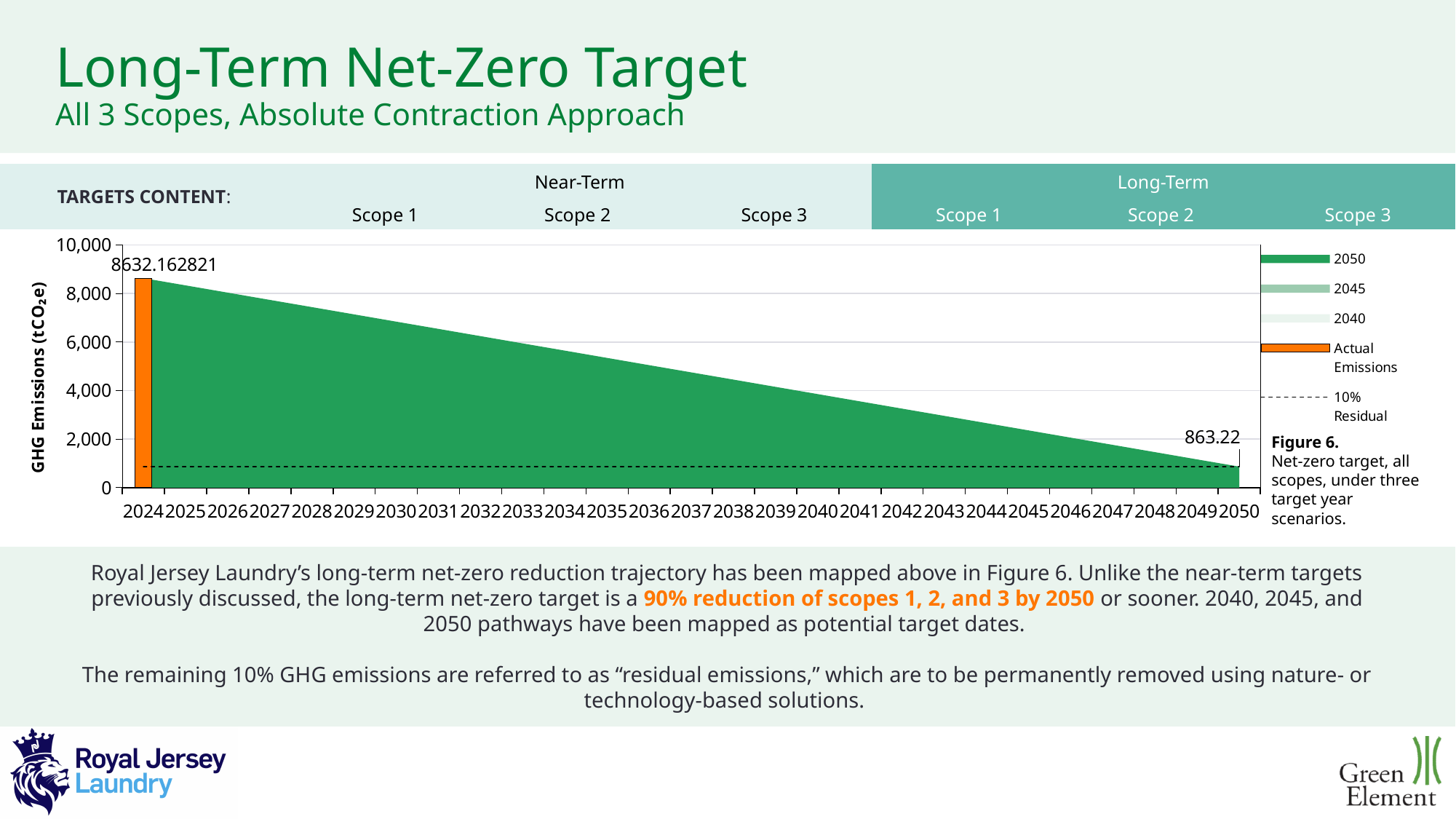
Is the value of the green trajectory in 2045 greater or less than 4,000? less What colour is the Actual Emissions bar in the chart? orange What value is labelled at the end of the trajectory in 2050? 863.22 Is the value of the green trajectory in 2030 greater or less than 6,000? greater What is the highest tick value shown on the y axis? 10,000 What is the label of the y axis? GHG Emissions (tCO₂e) Do the emissions values rise or fall along the x axis from 2024 to 2050? fall What is the difference between the 2024 actual emissions value and the 2050 value? 7768.942821 How many entries does the chart legend list? 5 What is the value of the actual emissions bar for 2024? 8632.162821 How many years are shown on the x axis? 27 Which is larger, the 2024 actual emissions value or the 2050 value? 2024 actual emissions